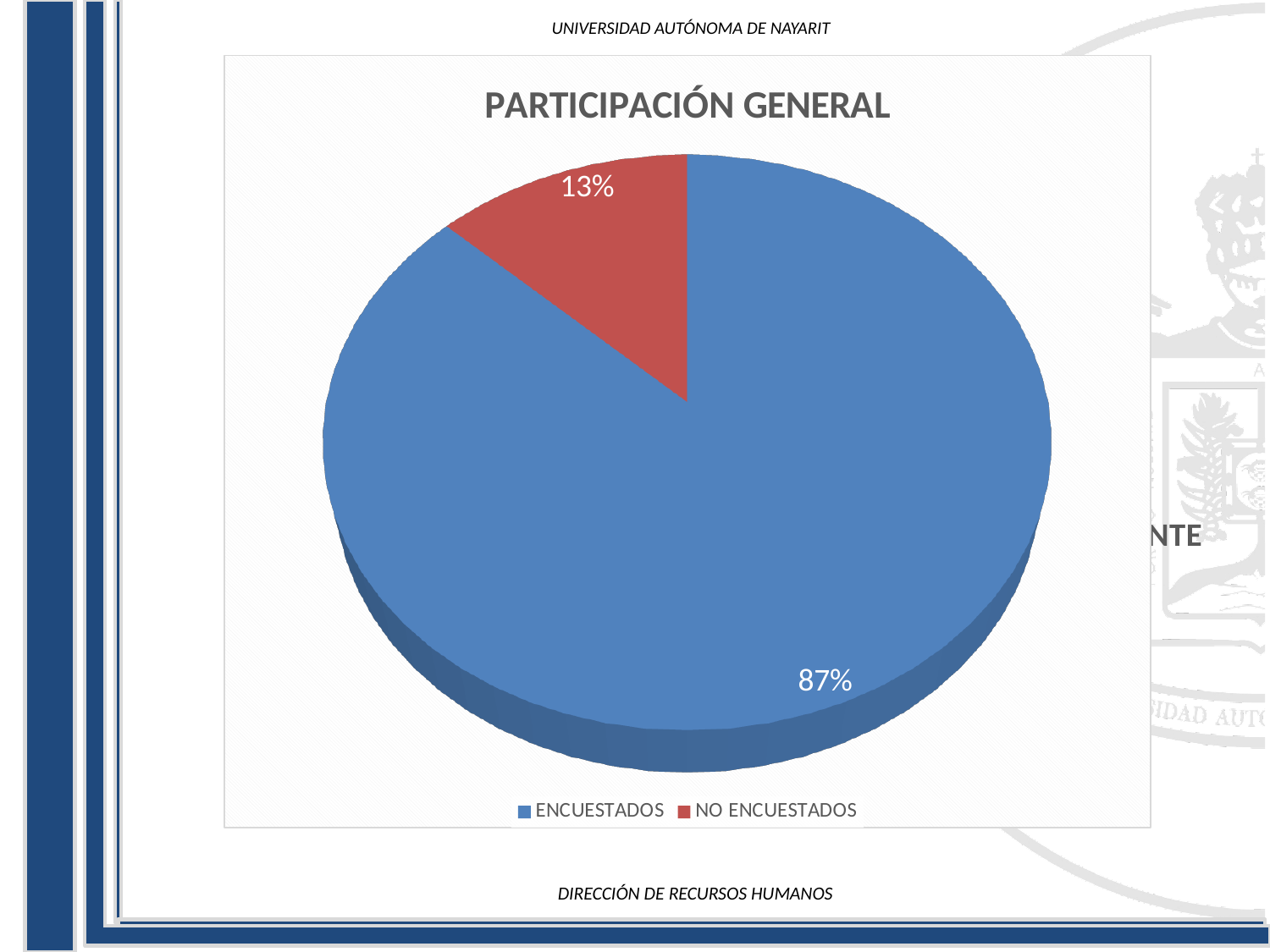
Which slice is the smallest? NO ENCUESTADOS What share of the pie is ENCUESTADOS? 87% Which is larger, ENCUESTADOS or NO ENCUESTADOS? ENCUESTADOS What type of chart is shown on the slide? Pie chart Is the share for ENCUESTADOS greater or less than 50%? greater Which slice is the largest? ENCUESTADOS What is the difference in percentage points between ENCUESTADOS and NO ENCUESTADOS? 74 What share of the pie is NO ENCUESTADOS? 13% How many slices does the pie chart have? 2 What colour is the NO ENCUESTADOS slice? Red How many entries does the legend list? 2 What is the title of the chart? PARTICIPACIÓN GENERAL